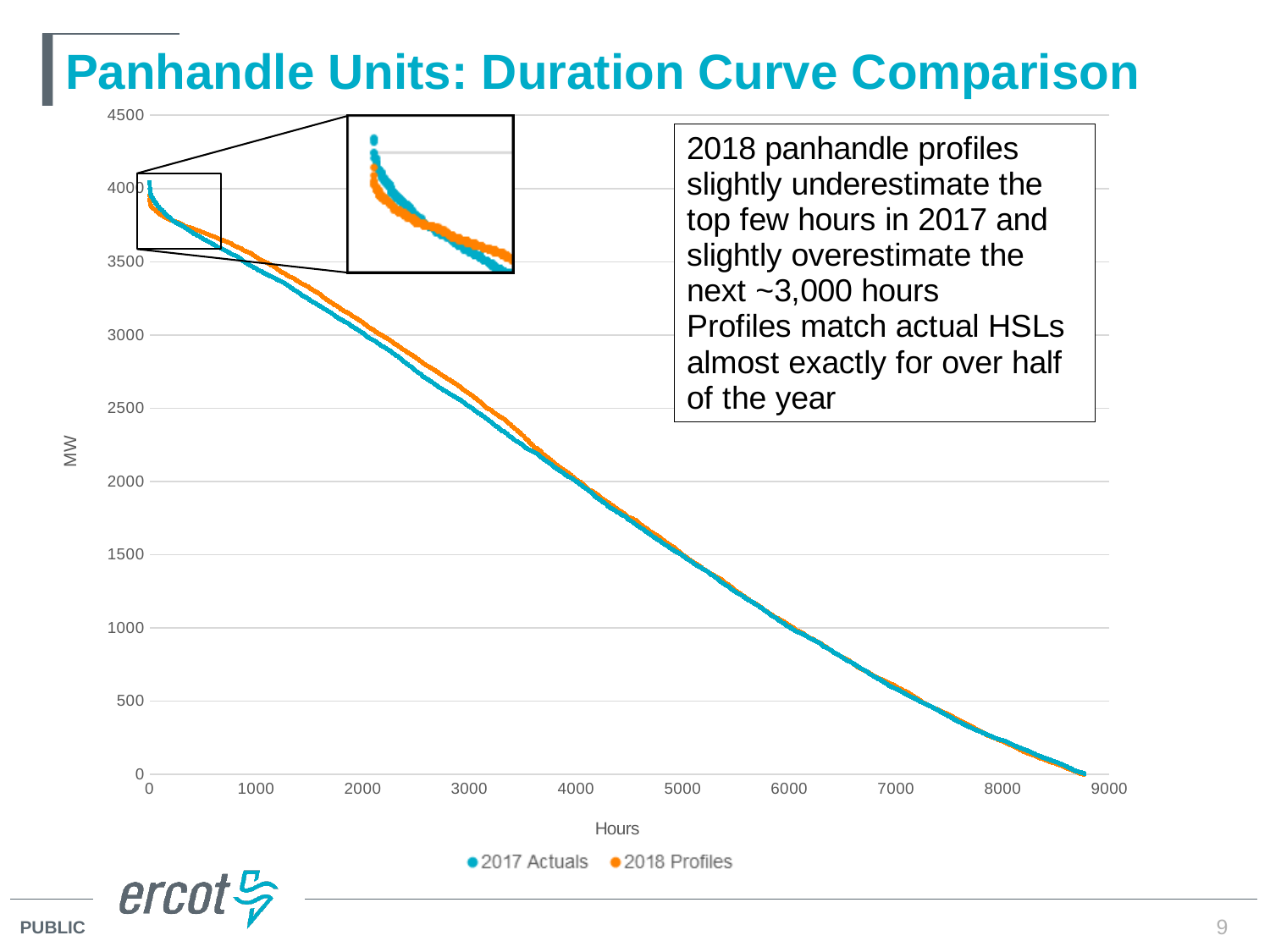
What kind of chart is shown on the slide? Scatter chart Is the MW value for 2018 Profiles at 2000 hours greater or less than 3500? less What are the two series named in the legend? 2017 Actuals and 2018 Profiles Is the MW value for 2017 Actuals at 7000 hours greater or less than 500? greater Is the MW value for 2017 Actuals at 7000 hours greater or less than 1000? less At 1000 hours, which series has the higher MW value, 2017 Actuals or 2018 Profiles? 2018 Profiles How many series does the legend list? 2 What is the title of the chart on the slide? Panhandle Units: Duration Curve Comparison At 2000 hours, which series has the higher MW value, 2017 Actuals or 2018 Profiles? 2018 Profiles Do the MW values rise or fall as Hours increase along the x axis? Fall